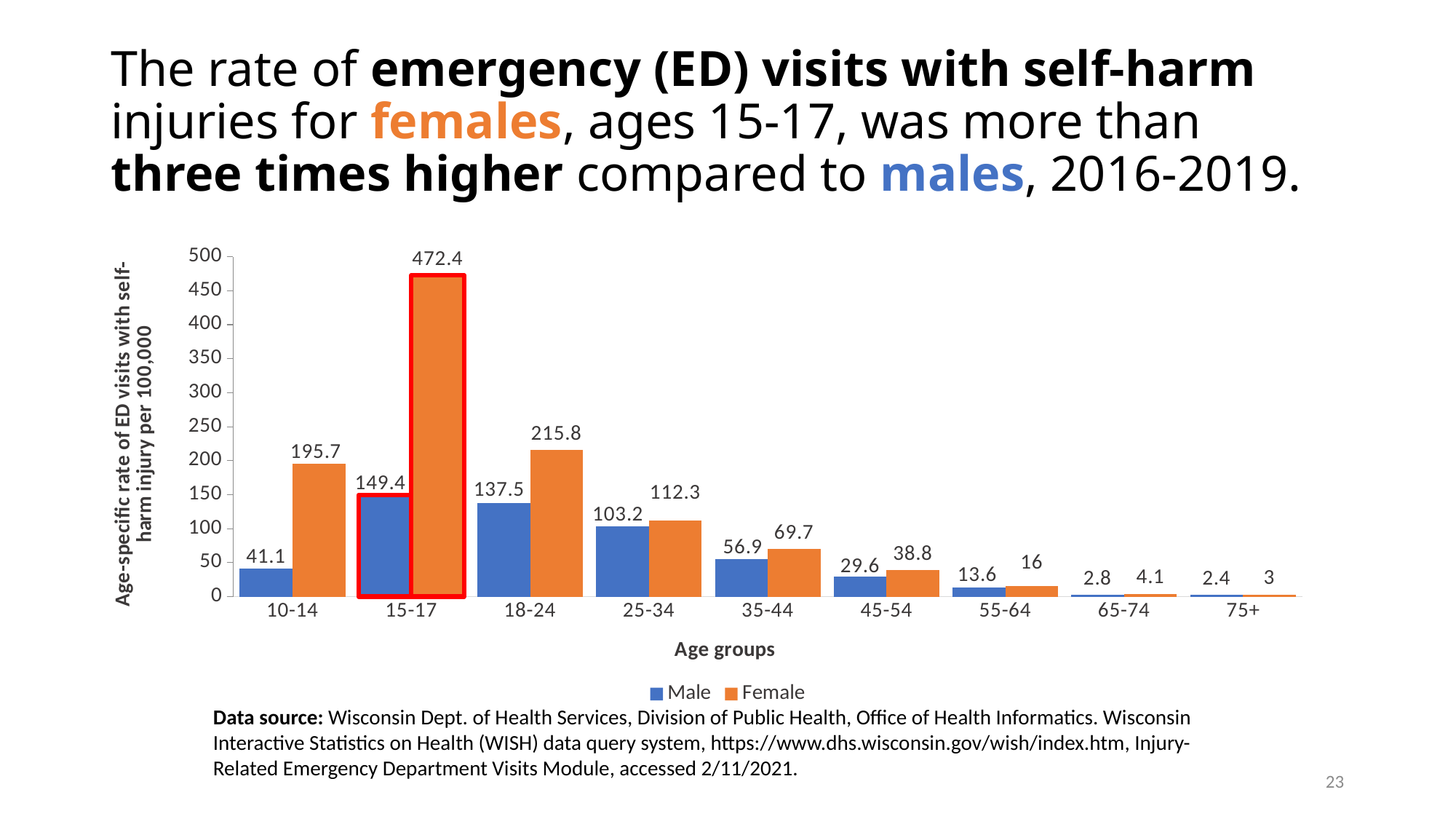
Which is larger, the Male rate for 25-34 or the Female rate for 35-44? Male rate for 25-34 What kind of chart is shown on the slide? Bar chart What is the difference between the Female and Male rates for the 15-17 age group? 323 What is the Male rate of ED visits with self-harm injury for the 18-24 age group? 137.5 What is the difference between the Female rates for the 10-14 and 18-24 age groups? 20.1 What is the Female rate of ED visits with self-harm injury for the 15-17 age group? 472.4 How many series does the legend list? 2 How many age groups are shown on the x axis? 9 What is the Female rate for the 55-64 age group? 16 Which age group has the lowest Male rate? 75+ Which age group has the highest Female rate? 15-17 Which age group's bars are outlined in red? 15-17